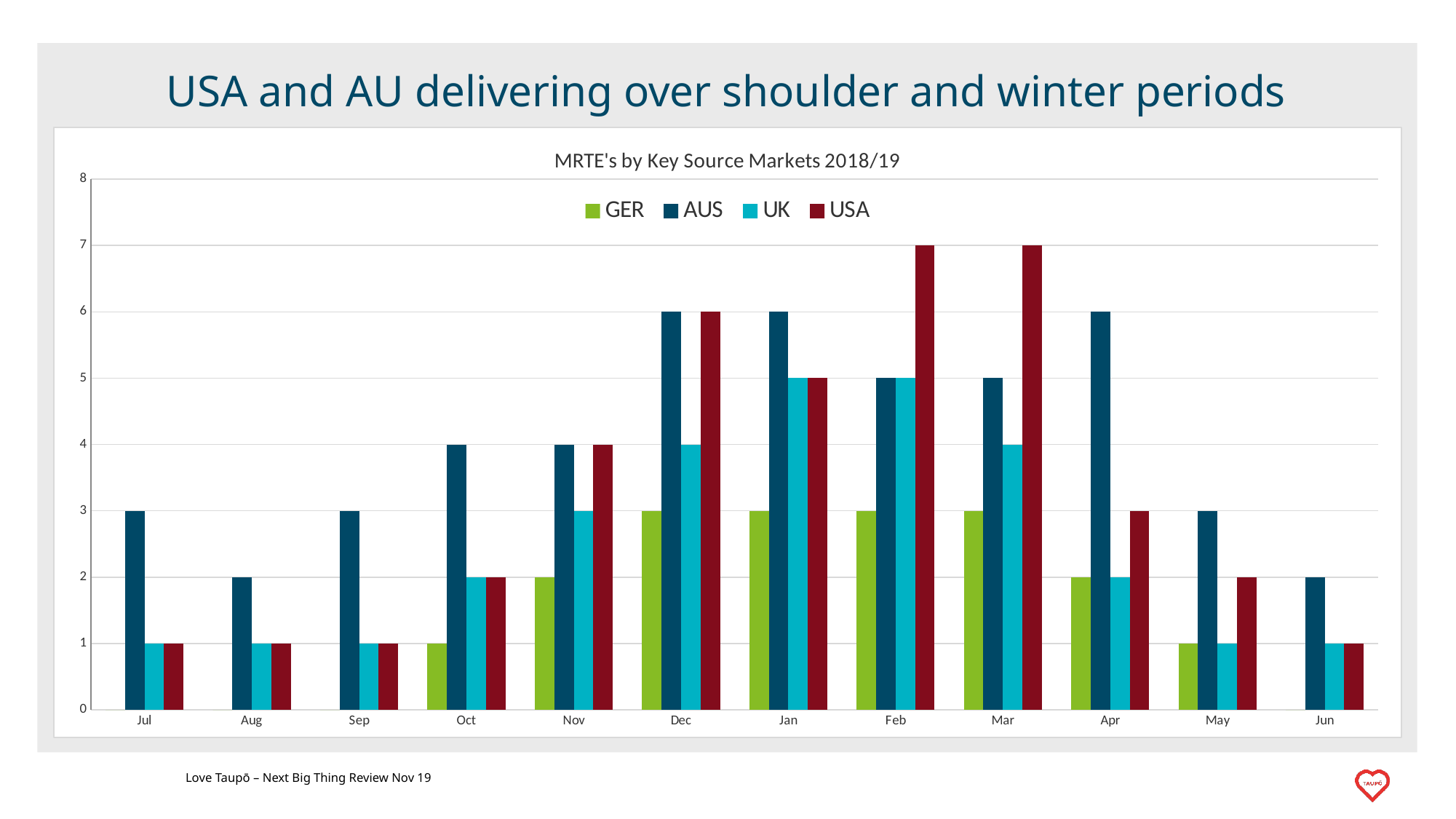
Which series has the highest value in Mar? USA Which series has the lowest value in Nov? GER How many series does the legend list? 4 What is the USA value for Feb? 7 How many months are shown on the x axis? 12 What is the difference between the USA and GER values in Feb? 4 From Mar to Jun, do the USA values rise or fall? Fall In Apr, which is larger, the AUS value or the USA value? AUS What is the UK value for Jan? 5 What is the GER value for Apr? 2 What kind of chart is shown on the slide? Bar chart What is the AUS value for Dec? 6